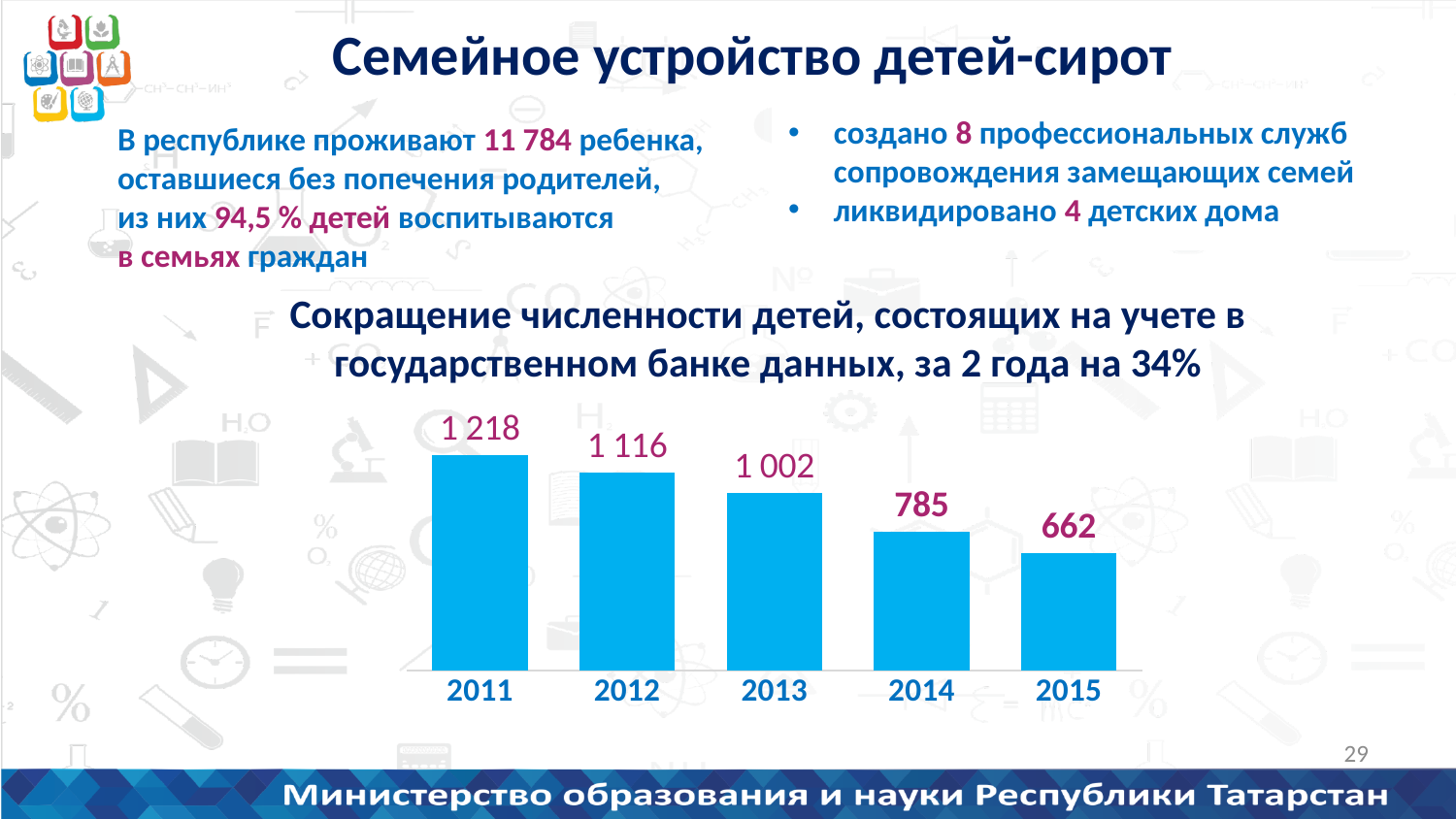
Which year has the highest value? 2011 What colour are the bars in the chart? blue Which year has the lowest value? 2015 What is the value for 2011? 1 218 Which is larger, the value for 2012 or the value for 2014? 2012 What is the value for 2013? 1 002 What is the difference between the values for 2011 and 2015? 556 What is the difference between the values for 2013 and 2014? 217 What kind of chart is shown on the slide? bar chart Do the values rise or fall from 2011 to 2015? fall How many years are shown on the chart? 5 What is the value for 2015? 662